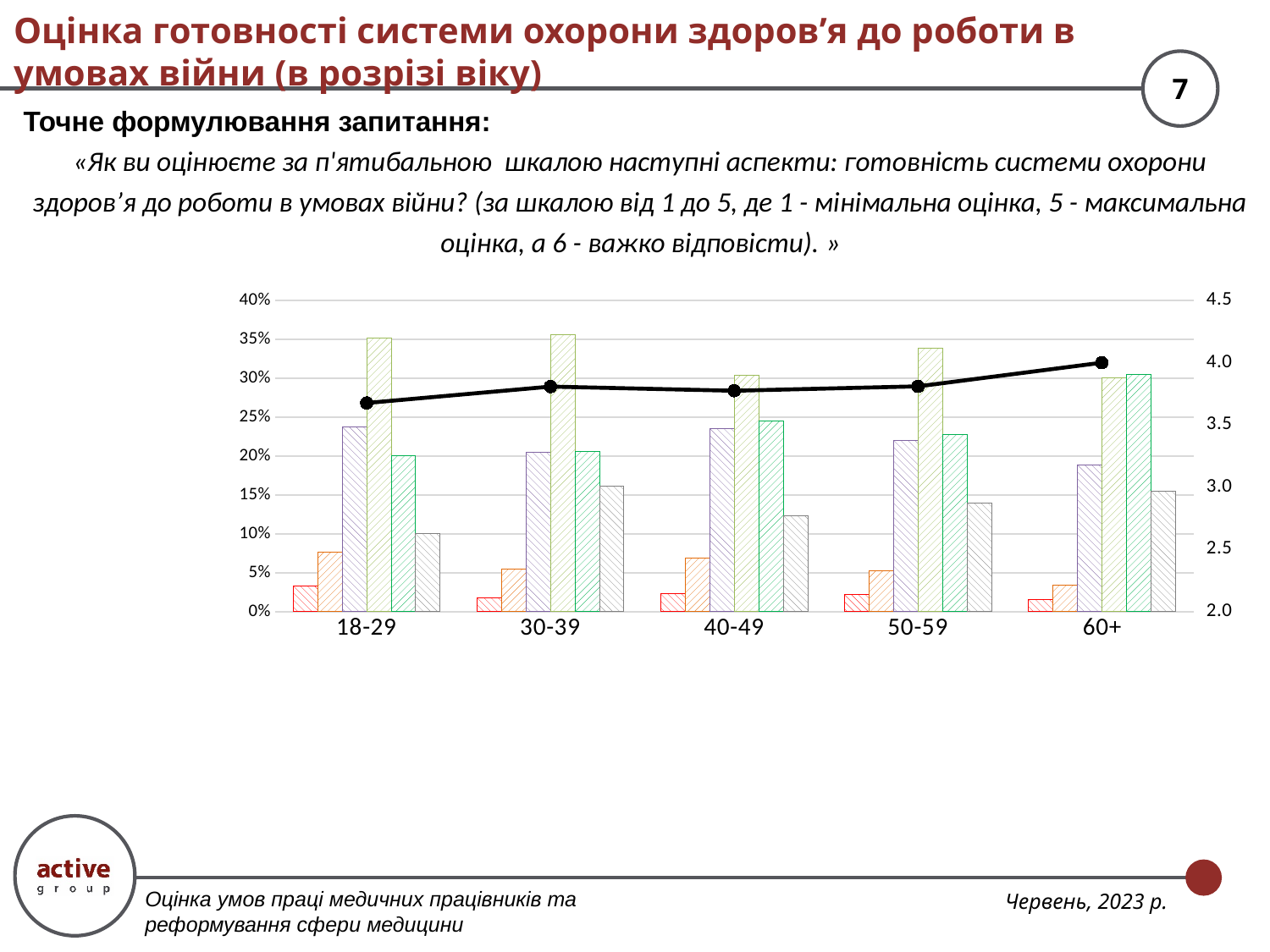
How many age groups are shown on the x axis of the chart? 5 Which is larger: the green bar for 60+ or the green bar for 18-29? 60+ Is the black line value for 18-29 greater or less than 4.0 on the right axis? less Which age group has the lowest value on the black line? 18-29 Which age group has the highest value on the black line? 60+ What kind of chart is shown on the slide? bar chart with a line Is the black line value for 30-39 greater or less than 3.5 on the right axis? greater How many bars are plotted for each age group in the chart? 6 What is the maximum value shown on the left vertical axis of the chart? 40% Is the tallest bar in the 18-29 group greater or less than 30%? greater